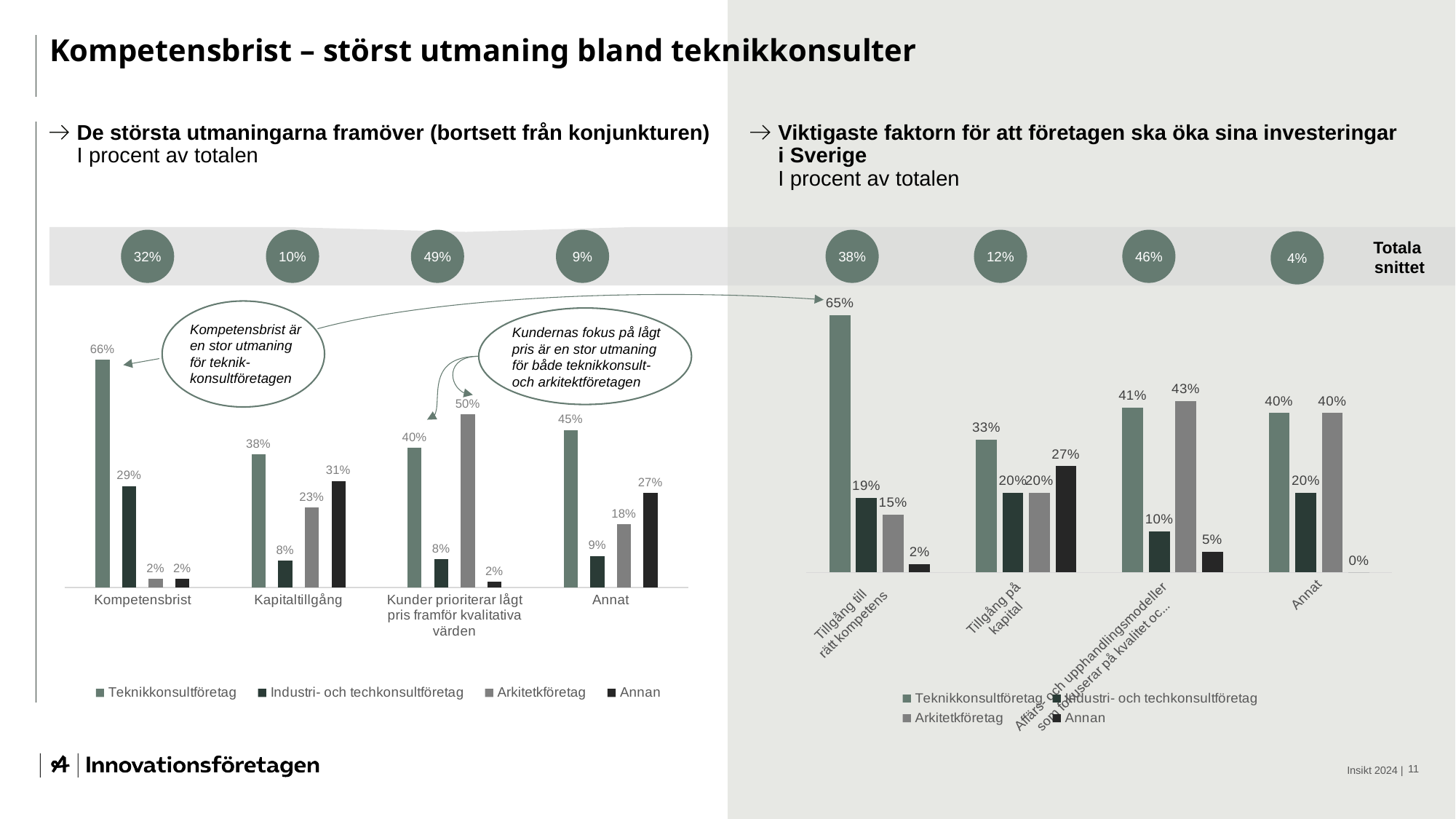
In the right chart (Viktigaste faktorn för att företagen ska öka sina investeringar i Sverige), what is the difference between the Arkitektföretag value and the Industri- och techkonsultföretag value in the 'Affärs- och upphandlingsmodeller' category? 33% In the right chart (Viktigaste faktorn för att företagen ska öka sina investeringar i Sverige), which series has the lowest value in the category 'Tillgång på kapital'? Industri- och techkonsultföretag and Arkitektföretag (both 20%) In the right chart (Viktigaste faktorn för att företagen ska öka sina investeringar i Sverige), what is the value for Teknikkonsultföretag in the category 'Tillgång till rätt kompetens'? 65% In the left chart (De största utmaningarna framöver), what is the value for Arkitektföretag in the category 'Kunder prioriterar lågt pris framför kvalitativa värden'? 50% What type of chart is the left chart (De största utmaningarna framöver)? Bar chart In the right chart (Viktigaste faktorn för att företagen ska öka sina investeringar i Sverige), what is the value for Annan in the Annat category? 0% In the left chart (De största utmaningarna framöver), how many categories are shown on the x axis? 4 In the left chart (De största utmaningarna framöver), what is the difference between the Teknikkonsultföretag value for Kompetensbrist and the Industri- och techkonsultföretag value for Kompetensbrist? 37% In the left chart (De största utmaningarna framöver), how many series does the legend list? 4 In the left chart (De största utmaningarna framöver), what is the value for Teknikkonsultföretag in the Kompetensbrist category? 66% In the right chart (Viktigaste faktorn för att företagen ska öka sina investeringar i Sverige), which is larger in the 'Tillgång på kapital' category: Teknikkonsultföretag or Annan? Teknikkonsultföretag In the left chart (De största utmaningarna framöver), which series has the highest value in the Kapitaltillgång category? Teknikkonsultföretag